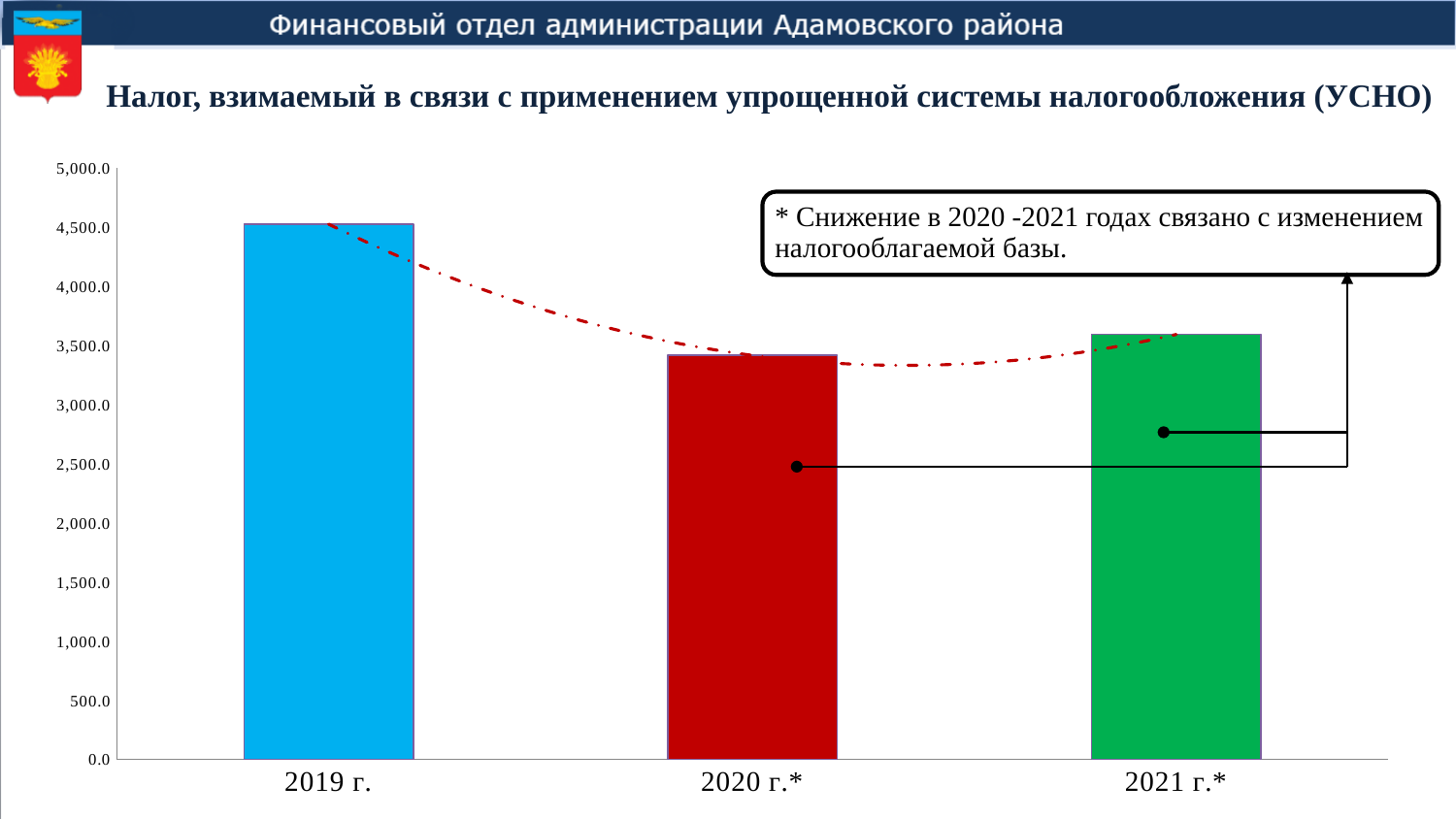
Which year has the highest value on the chart? 2019 г. Which year has the lowest value on the chart? 2020 г.* How do the values change from 2019 г. to 2021 г.*? They fall from 2019 to 2020, then rise slightly in 2021 What is the title of the chart on the slide? Налог, взимаемый в связи с применением упрощенной системы налогообложения (УСНО) How many years (categories) are plotted on the chart? 3 Is the value for 2020 г.* greater or less than 3,000.0? greater Is the value for 2020 г.* greater or less than 3,500.0? less What colour is the bar for 2020 г.*? Red What kind of chart is shown on the slide? Bar chart Is the value for 2019 г. greater or less than 4,000.0? greater Which is larger, the value for 2020 г.* or the value for 2021 г.*? 2021 г.*